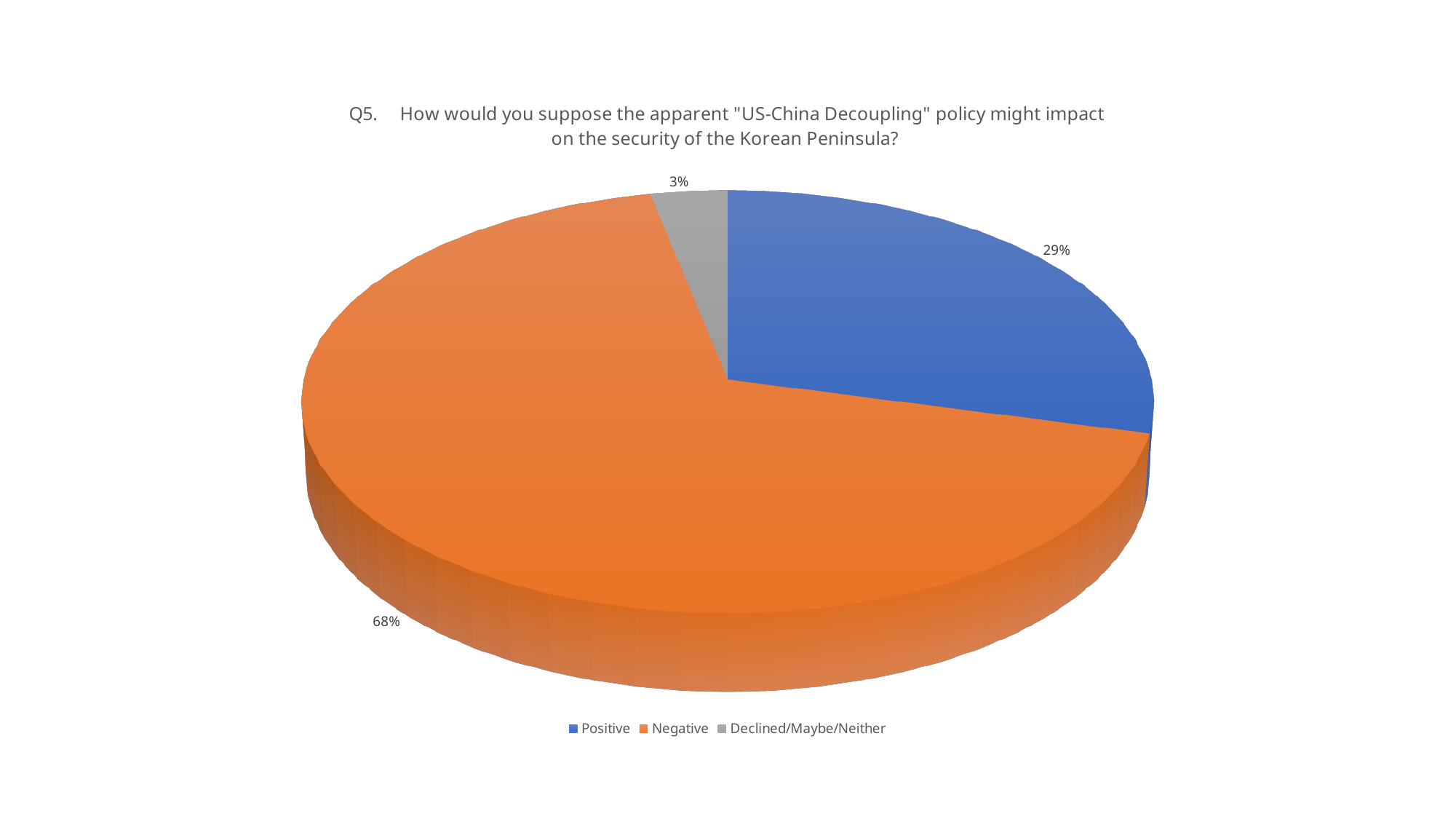
Which response category has the smallest share of the pie? Declined/Maybe/Neither What is the difference in percentage points between the Negative and Positive shares? 39 Which is larger, the Positive share or the Declined/Maybe/Neither share? Positive What is the combined share of Positive and Declined/Maybe/Neither responses? 32% What percentage of respondents answered Declined/Maybe/Neither? 3% What percentage of respondents answered Positive? 29% Which colour represents the Negative category in the pie chart? Orange What kind of chart is shown on the slide? Pie chart Which response category has the largest share of the pie? Negative How many categories are shown in the pie chart? 3 What percentage of respondents answered Negative? 68% What question number is shown in the chart title? Q5